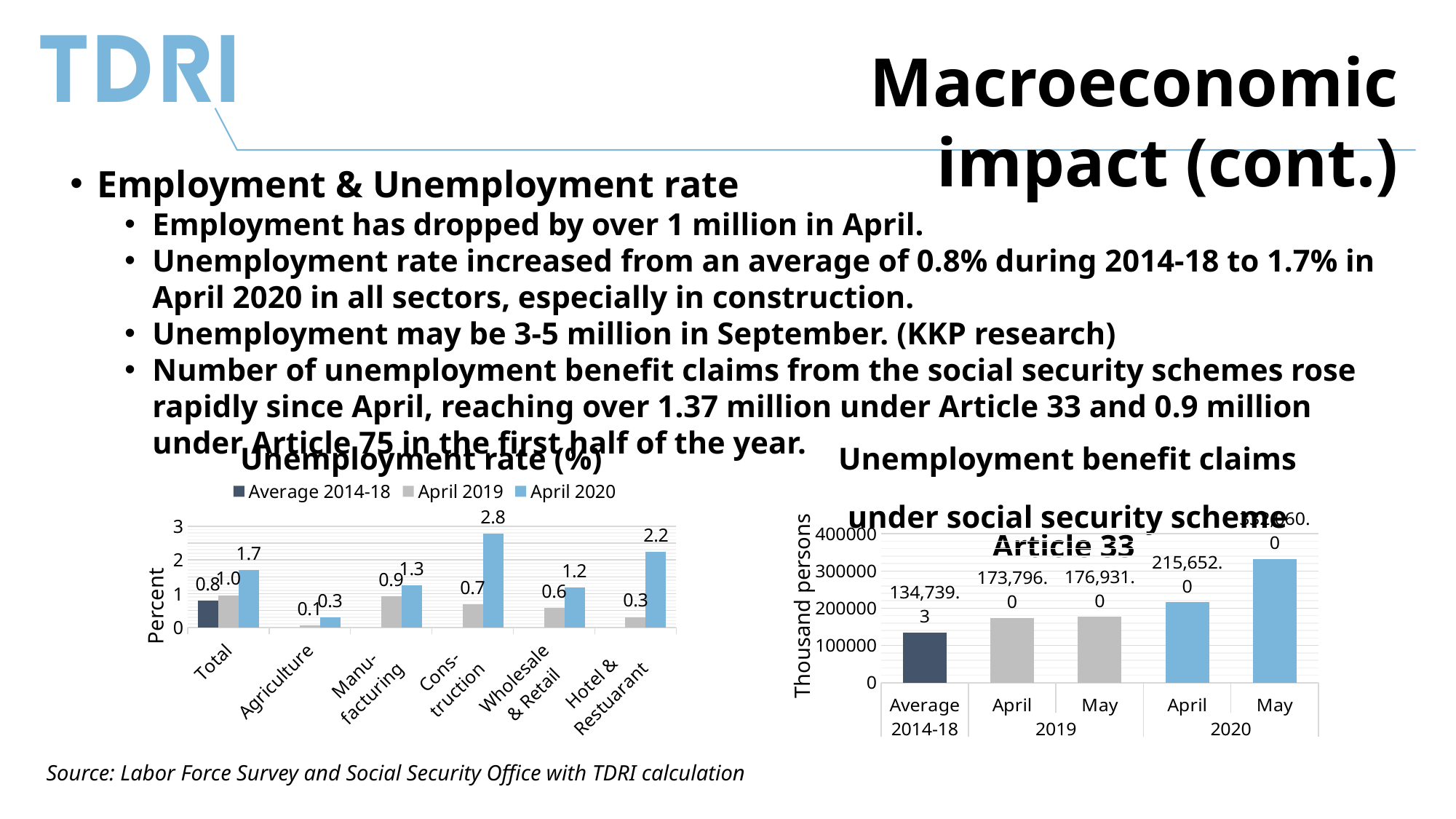
In the 'Unemployment benefit claims under social security scheme Article 33' chart, what is the value for April 2020? 215,652.0 In the 'Unemployment benefit claims under social security scheme Article 33' chart, what is the value for Average 2014-18? 134,739.3 What kind of chart is the 'Unemployment rate (%)' chart on the left? Bar chart In the 'Unemployment rate (%)' chart, which sector has the highest April 2020 unemployment rate? Construction How many sector categories are shown on the x axis of the 'Unemployment rate (%)' chart? 6 In the 'Unemployment rate (%)' chart, which sector has the lowest April 2020 unemployment rate? Agriculture In the 'Unemployment rate (%)' chart, how much higher is the Total rate in April 2020 than the Average 2014-18? 0.9 In the 'Unemployment benefit claims under social security scheme Article 33' chart, is the value for May 2020 greater or less than 300000? greater In the 'Unemployment rate (%)' chart, what is the April 2020 unemployment rate for Construction? 2.8 How many series does the legend of the 'Unemployment rate (%)' chart list? 3 In the 'Unemployment rate (%)' chart, which has the higher April 2020 rate: Hotel & Restaurant or Wholesale & Retail? Hotel & Restaurant In the 'Unemployment benefit claims under social security scheme Article 33' chart, do the values rise or fall from left to right along the x axis? Rise